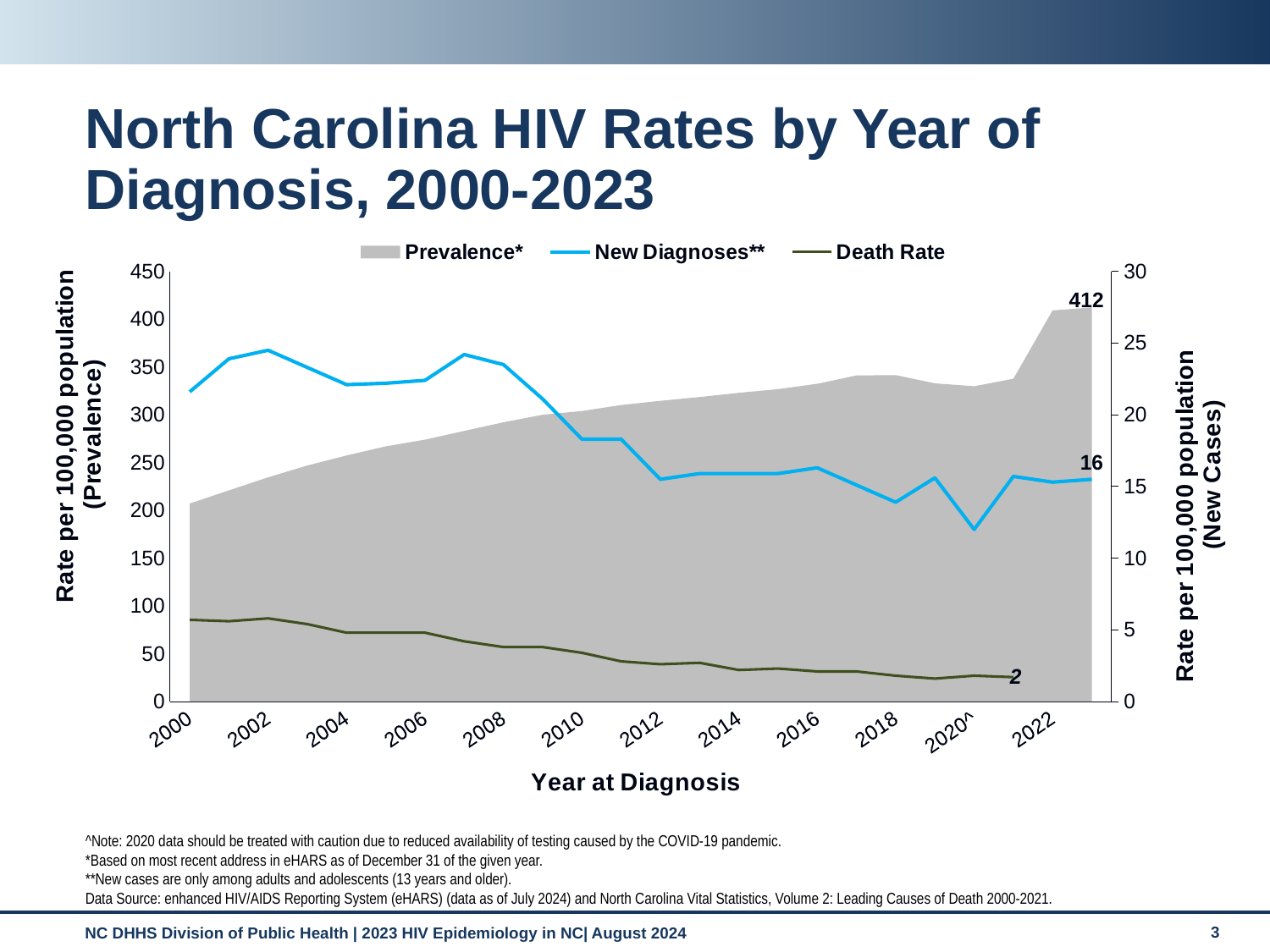
What is the title of the x axis? Year at Diagnosis Does the Prevalence series rise or fall overall from 2000 to 2023? rise What is the last labeled value on the Death Rate line? 2 What is the labeled Prevalence value for 2023? 412 Is the Prevalence value for 2000 greater or less than 250? less What kind of chart is shown on the slide? area and line chart Does the Death Rate series rise or fall overall across the years shown? fall Is the New Diagnoses value for 2020^ greater or less than 15? less What is the labeled New Diagnoses value for 2023? 16 Which year has the lowest New Diagnoses rate? 2020^ Is the New Diagnoses value for 2000 greater or less than 20 on the right axis? greater How many series does the legend list? 3